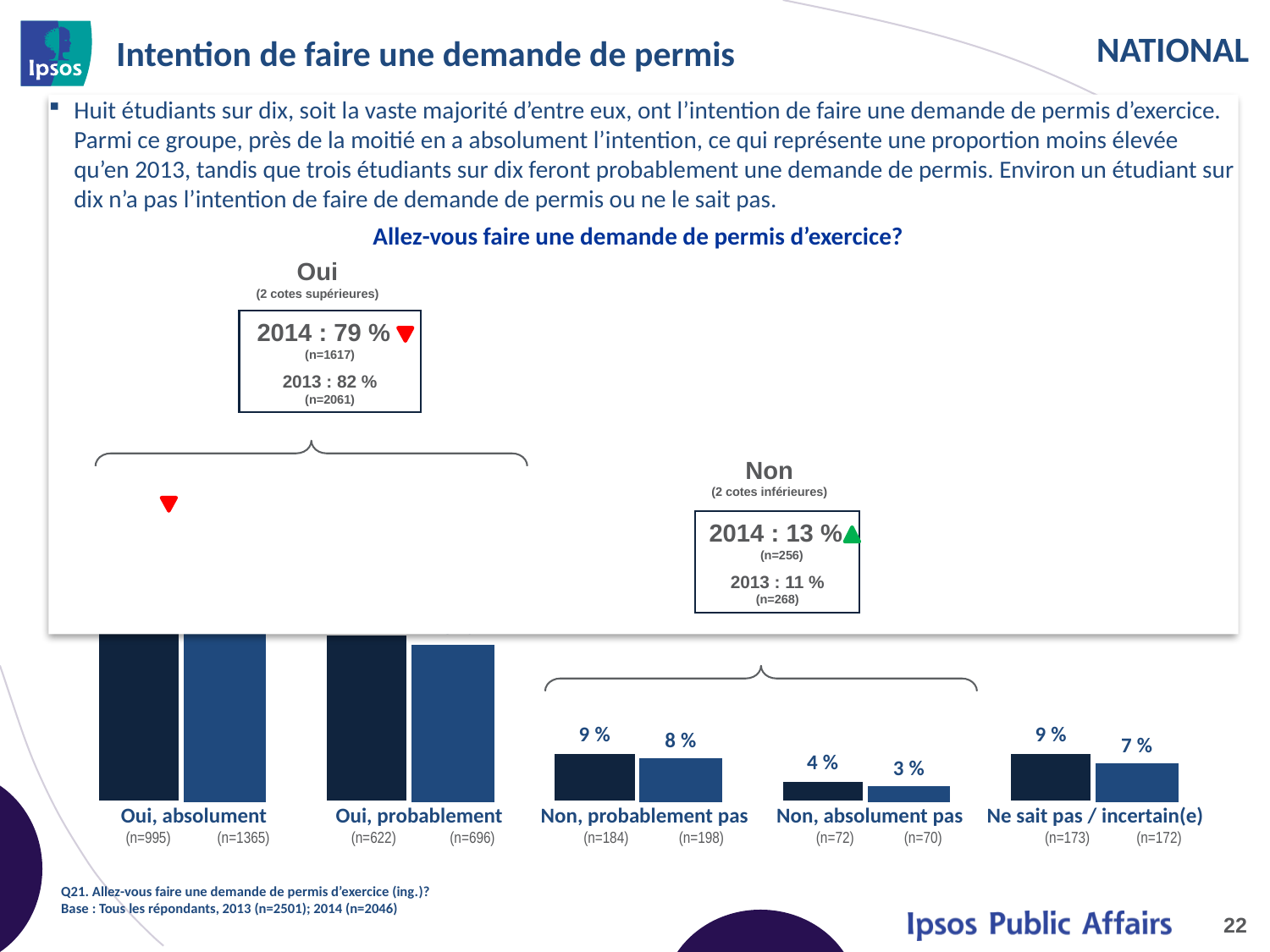
What is the value of the dark navy (left) bar for "Non, probablement pas"? 9 % Among the three categories with printed data labels, which has the lowest values? Non, absolument pas What is the question title shown above the chart? Allez-vous faire une demande de permis d'exercice? For "Non, probablement pas", which bar is larger, the dark navy (left) bar or the lighter blue (right) bar? the dark navy (left) bar Which category has taller bars, "Oui, absolument" or "Non, probablement pas"? Oui, absolument How many response categories are shown along the x axis of the chart? 5 According to the "Oui (2 cotes supérieures)" box, what was the 2014 percentage? 79 % What is the value of the lighter blue (right) bar for "Non, absolument pas"? 3 % What is the value of the lighter blue (right) bar for "Non, probablement pas"? 8 % What is the difference between the two bars for "Ne sait pas / incertain(e)"? 2 percentage points What kind of chart is shown on the slide? bar chart What is the value of the dark navy (left) bar for "Ne sait pas / incertain(e)"? 9 %